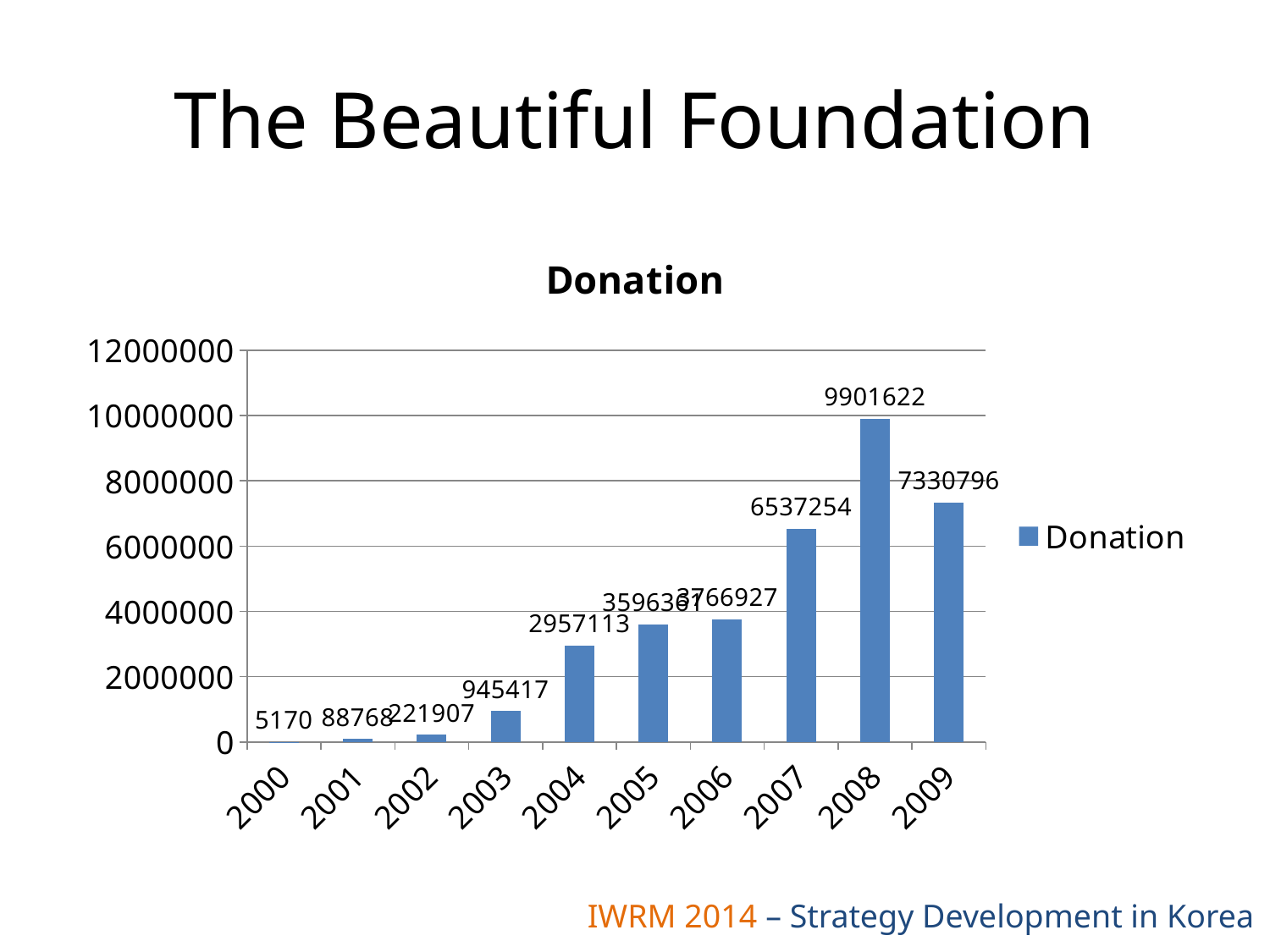
What is the difference between the donation values for 2007 and 2006? 2770327 What is the difference between the donation values for 2008 and 2009? 2570826 What is the donation value for 2008? 9901622 How many series does the legend list? 1 Which year has the larger donation value, 2007 or 2009? 2009 Which year has the lowest donation value? 2000 How many years are shown on the x axis of the chart? 10 Is the donation value for 2005 greater or less than 4000000? less What is the donation value for 2009? 7330796 What is the donation value for 2003? 945417 What kind of chart is shown on the slide? bar chart Which year has the highest donation value? 2008